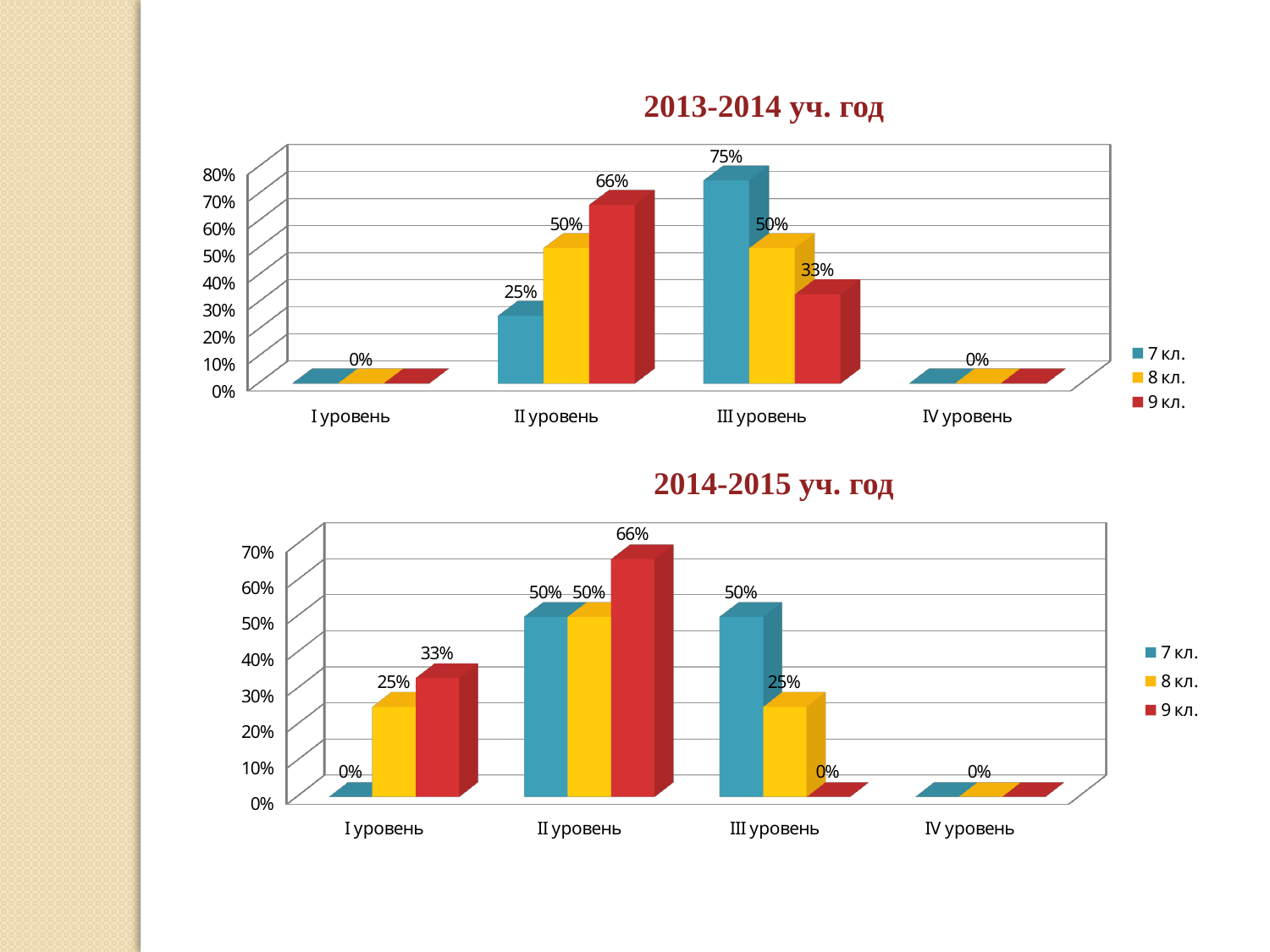
In the chart titled "2013-2014 уч. год", which is larger at II уровень: the value for 7 кл. or the value for 8 кл.? 8 кл. In the chart titled "2014-2015 уч. год", what is the value for 9 кл. at I уровень? 33% In the chart titled "2014-2015 уч. год", how many categories are shown on the x axis? 4 In the chart titled "2014-2015 уч. год", what is the difference between the 9 кл. value and the 8 кл. value at II уровень? 16% What type of chart is the chart titled "2014-2015 уч. год"? Bar chart In the chart titled "2014-2015 уч. год", what is the value for 9 кл. at III уровень? 0% In the chart titled "2014-2015 уч. год", what is the value for 8 кл. at III уровень? 25% In the chart titled "2013-2014 уч. год", how many series does the legend list? 3 In the chart titled "2013-2014 уч. год", what is the value for 7 кл. at II уровень? 25% In the chart titled "2013-2014 уч. год", what is the value for 9 кл. at II уровень? 66% In the chart titled "2013-2014 уч. год", what is the difference between the 7 кл. value and the 9 кл. value at III уровень? 42% In the chart titled "2013-2014 уч. год", what is the value for 7 кл. at III уровень? 75%